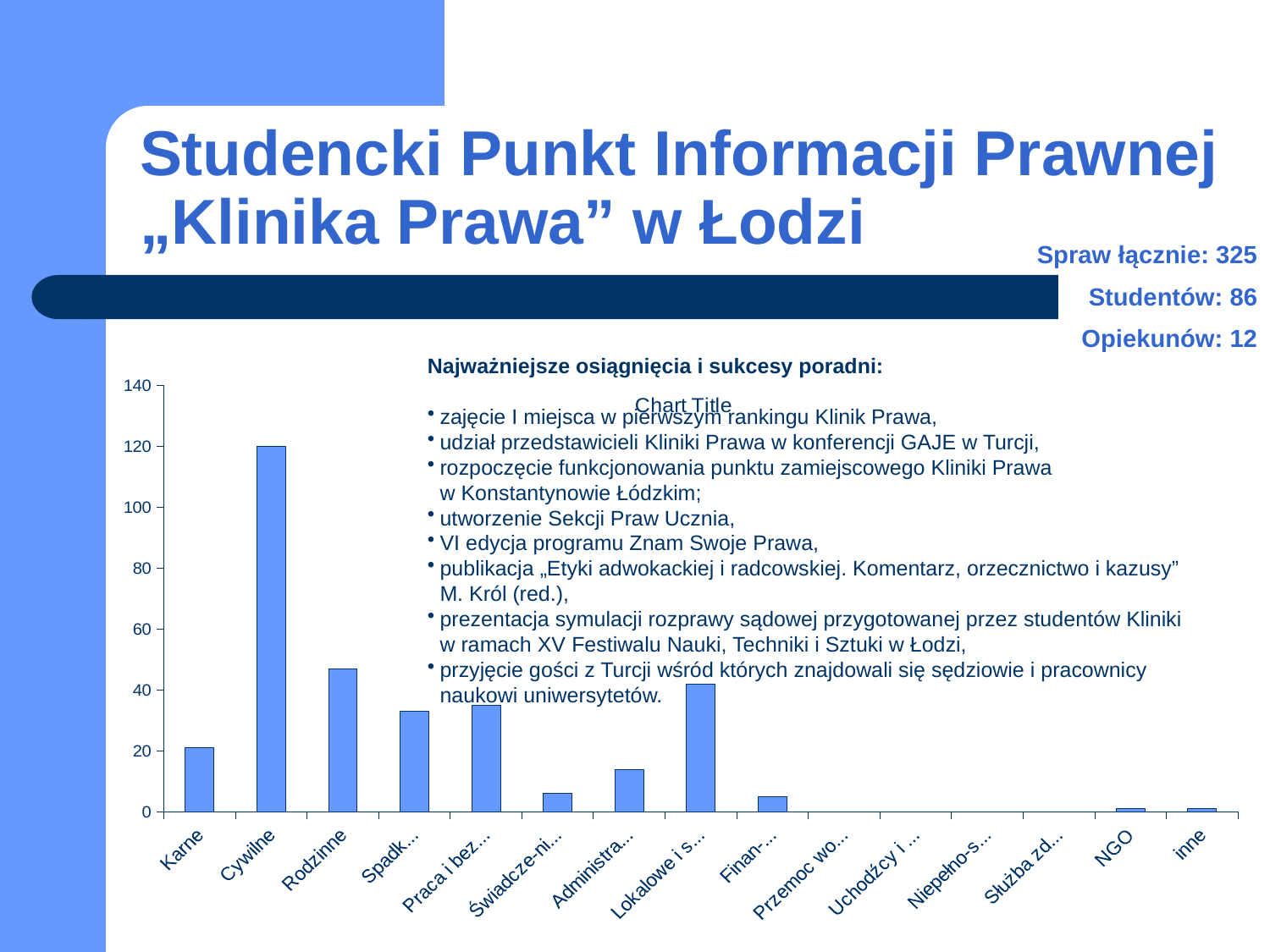
Is the value for Administra... greater or less than 20? less What kind of chart is shown on the slide? bar chart Is the value for Rodzinne greater or less than 60? less Is the value for Karne greater or less than 40? less What is the value for Cywilne in the chart? 120 Which category has the highest bar in the chart? Cywilne Which is larger, the value for Rodzinne or the value for Karne? Rodzinne What is the title shown on the chart? Chart Title Which is larger, the value for Cywilne or the value for Rodzinne? Cywilne How many categories are shown on the x axis of the chart? 15